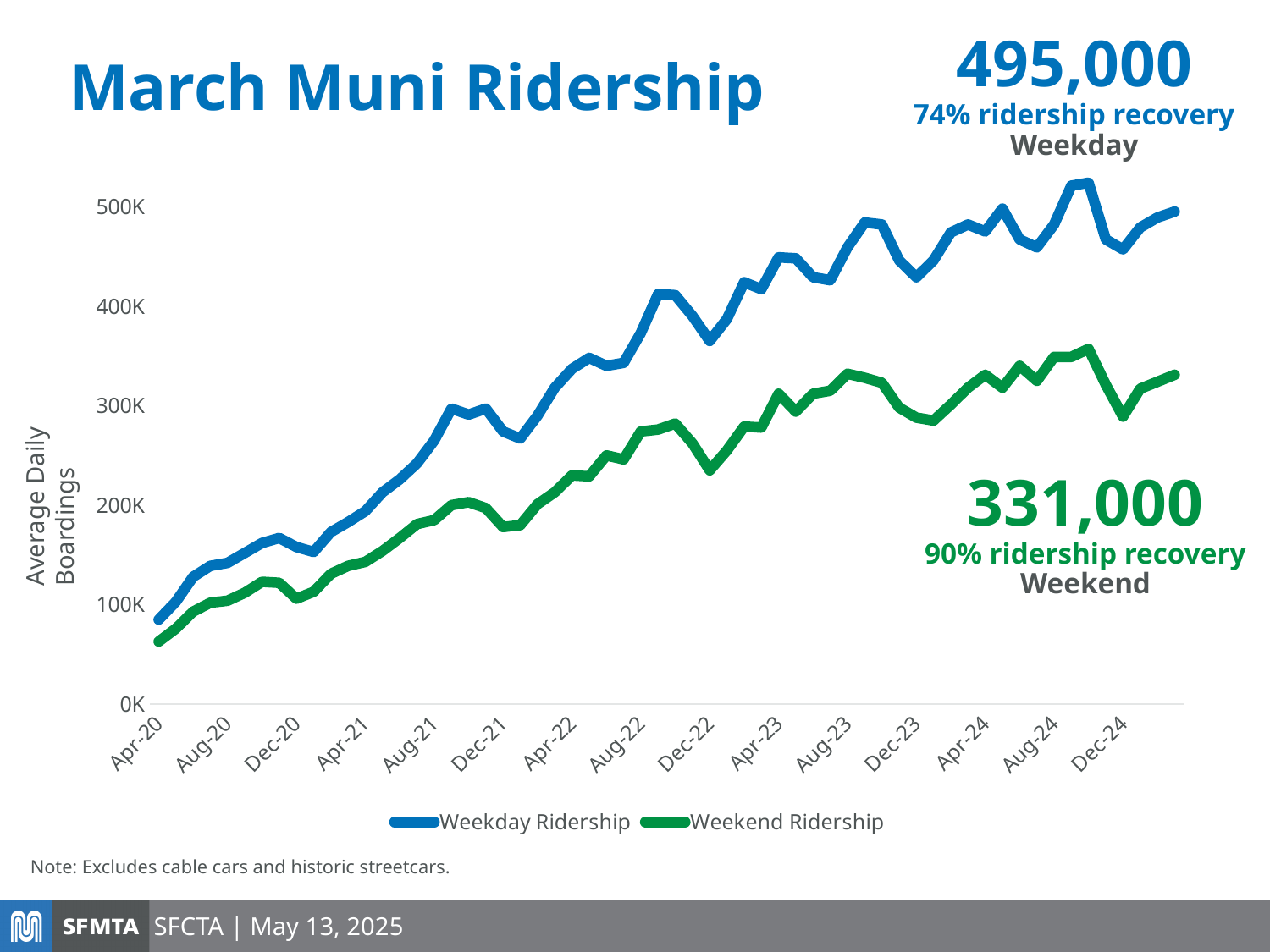
What kind of chart is shown on the slide? Line chart Is the Weekday Ridership value at Aug-23 greater or less than 400K? greater What is the March weekday ridership figure shown on the slide? 495,000 Which series is higher at the end of the chart, Weekday Ridership or Weekend Ridership? Weekday Ridership How many series does the legend list? 2 Overall, do the ridership values rise or fall from Apr-20 to the end of the chart? Rise What is the title of the chart? March Muni Ridership What is the March weekend ridership figure shown on the slide? 331,000 What is the difference between the March weekday ridership (495,000) and the March weekend ridership (331,000)? 164,000 Is the Weekday Ridership value at Apr-20 greater or less than 100K? less Is the Weekend Ridership value at Dec-22 greater or less than 300K? less What percentage ridership recovery is shown for weekend ridership? 90%